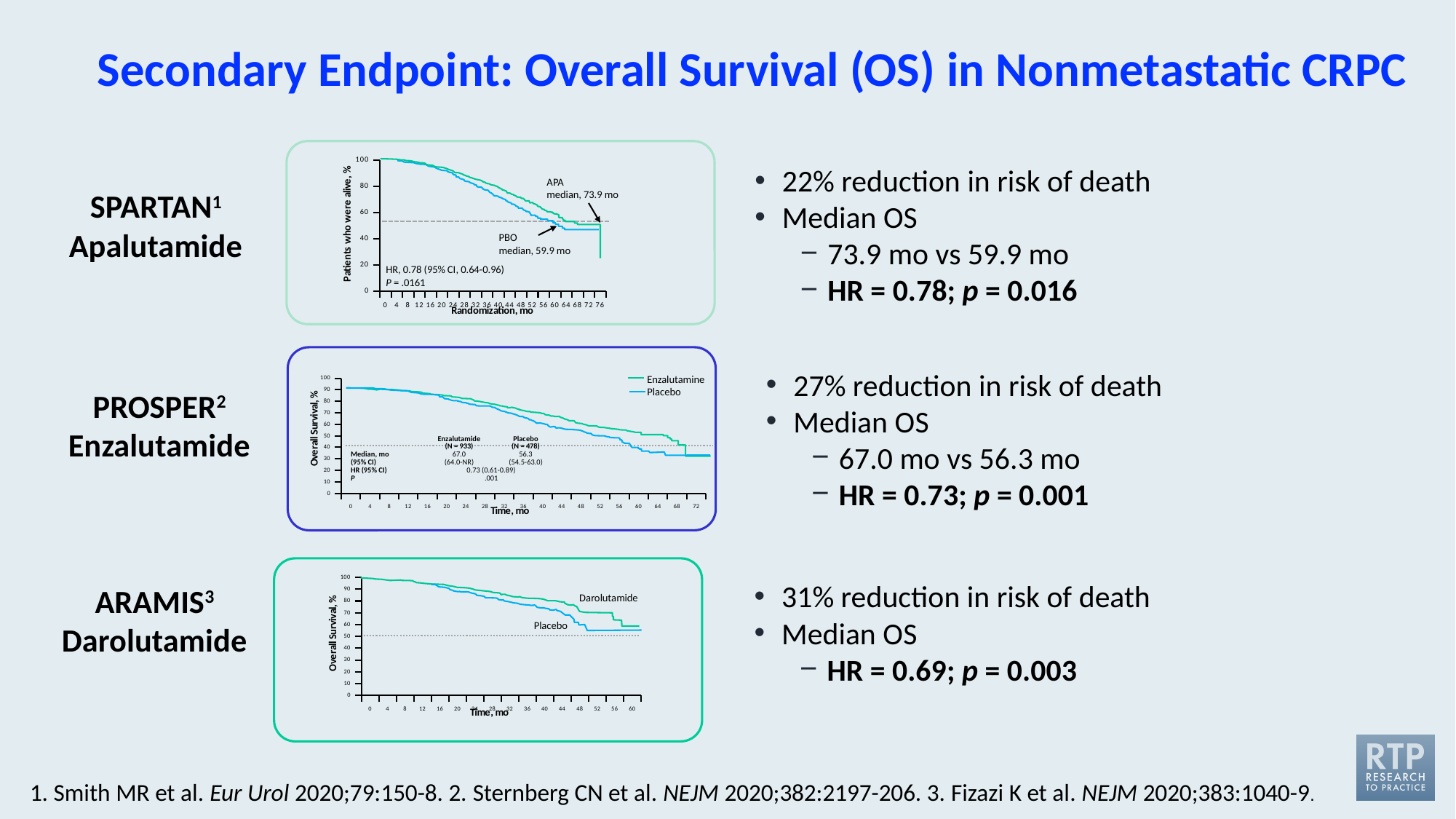
In the SPARTAN chart, what hazard ratio and 95% CI are printed? HR, 0.78 (95% CI, 0.64-0.96) In the SPARTAN chart, what is the difference between the APA and PBO median overall survival values? 14.0 mo In the PROSPER chart, what is the median overall survival for the Enzalutamide arm? 67.0 mo How many series does the legend of the PROSPER chart list? 2 In the ARAMIS chart, which curve is higher at 48 months, Darolutamide or Placebo? Darolutamide What is the y-axis label of the ARAMIS chart? Overall Survival, % In the PROSPER chart, how many patients were in the Enzalutamide arm? 933 In the SPARTAN chart, what is the median overall survival for the PBO arm? 59.9 mo In the PROSPER chart, what is the median overall survival for the Placebo arm? 56.3 mo In the PROSPER chart, what is the difference between the Enzalutamide and Placebo median overall survival values? 10.7 mo What kind of chart is the SPARTAN chart at the top of the slide? Line chart (Kaplan-Meier survival curve) In the SPARTAN chart, what is the median overall survival for the APA arm? 73.9 mo